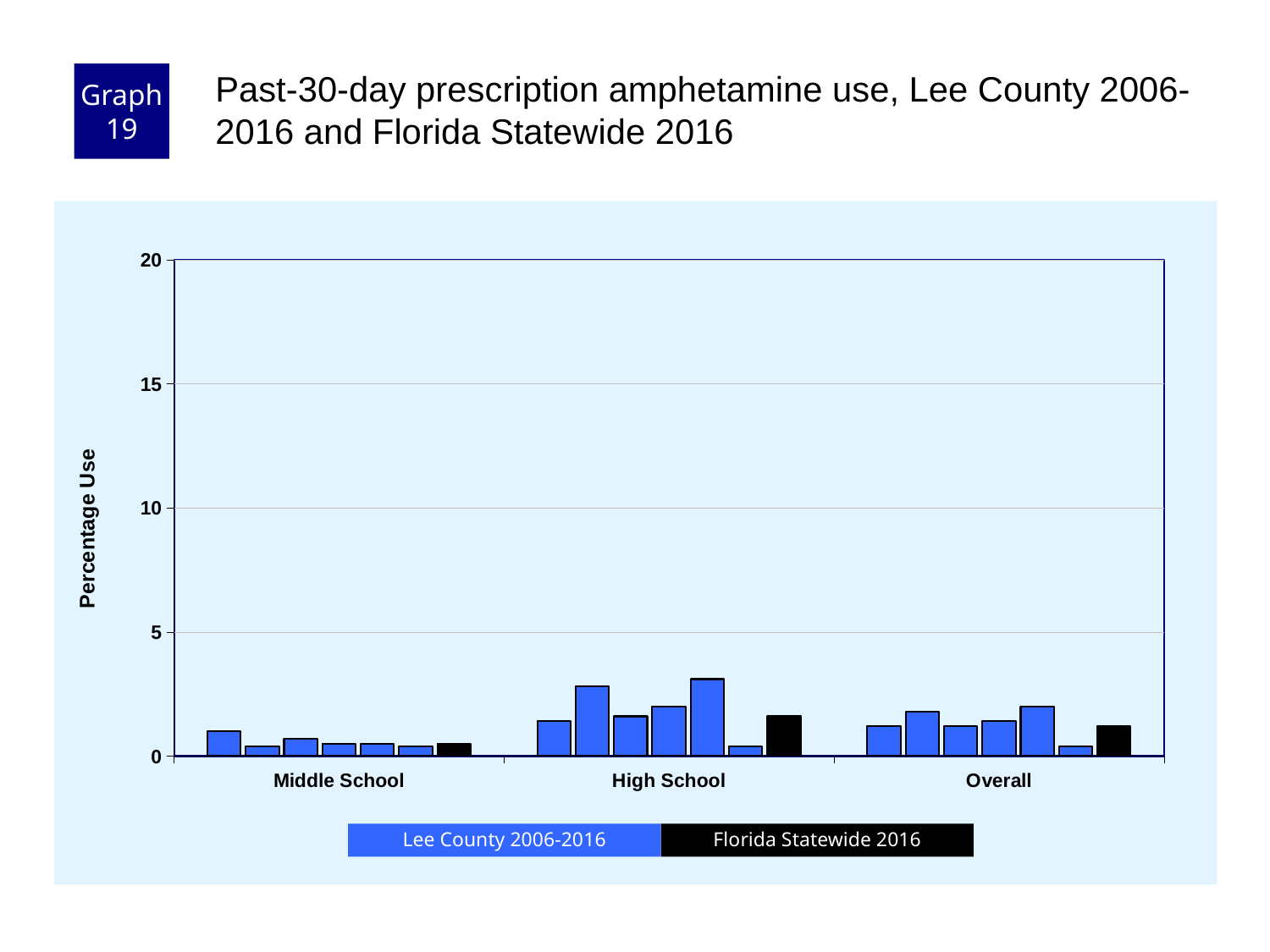
How many school-level categories are shown on the x axis? 3 What is the label on the y axis? Percentage Use Which series is drawn in black? Florida Statewide 2016 What kind of chart is shown on the slide? bar chart How many series does the legend list? 2 In which category is the Florida Statewide 2016 value lowest? Middle School Is the tallest Lee County 2006-2016 bar in the High School group greater or less than 5? less Is the Florida Statewide 2016 value for High School greater or less than 5? less Is the Florida Statewide 2016 value for Middle School greater or less than 5? less Which is larger: the Florida Statewide 2016 value for High School or for Middle School? High School Which category contains the tallest bar on the chart? High School In which category is the Florida Statewide 2016 value highest? High School